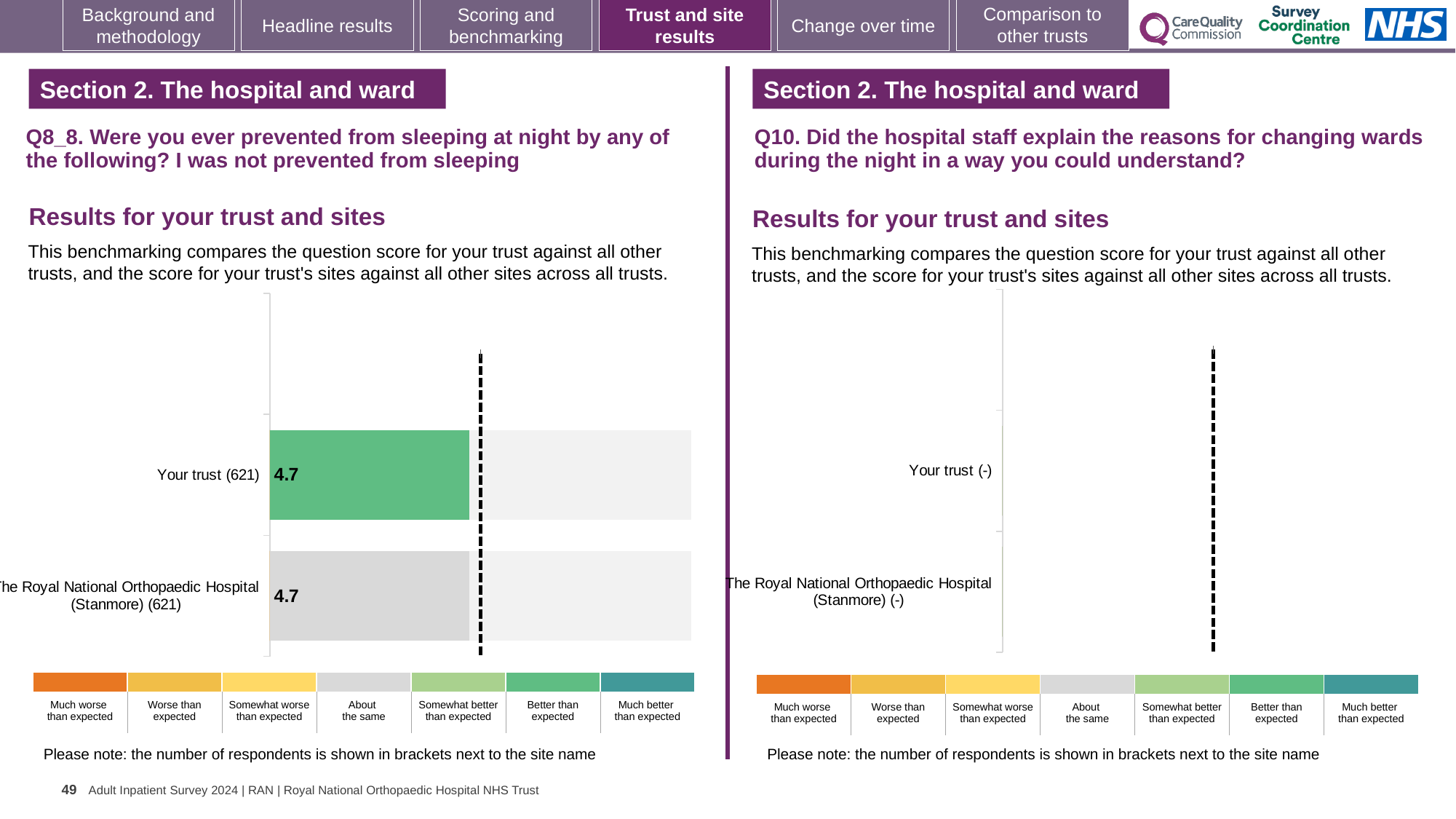
On the left chart (Q8_8), what is the difference between the score for Your trust and the score for The Royal National Orthopaedic Hospital (Stanmore)? 0 How many benchmark categories does the colour key below the left chart (Q8_8) list? 7 What kind of chart is the left chart (Q8_8)? bar chart On the left chart (Q8_8), how many respondents are shown in brackets next to Your trust? 621 On the left chart (Q8_8), what is the score for Your trust? 4.7 How many benchmark categories does the colour key below the right chart (Q10) list? 7 On the left chart (Q8_8), what is the score for The Royal National Orthopaedic Hospital (Stanmore)? 4.7 On the left chart (Q8_8), which benchmark category does the colour of the Your trust bar correspond to in the colour key? Better than expected On the left chart (Q8_8), how many bars are plotted? 2 On the right chart (Q10), how many bars are plotted? 0